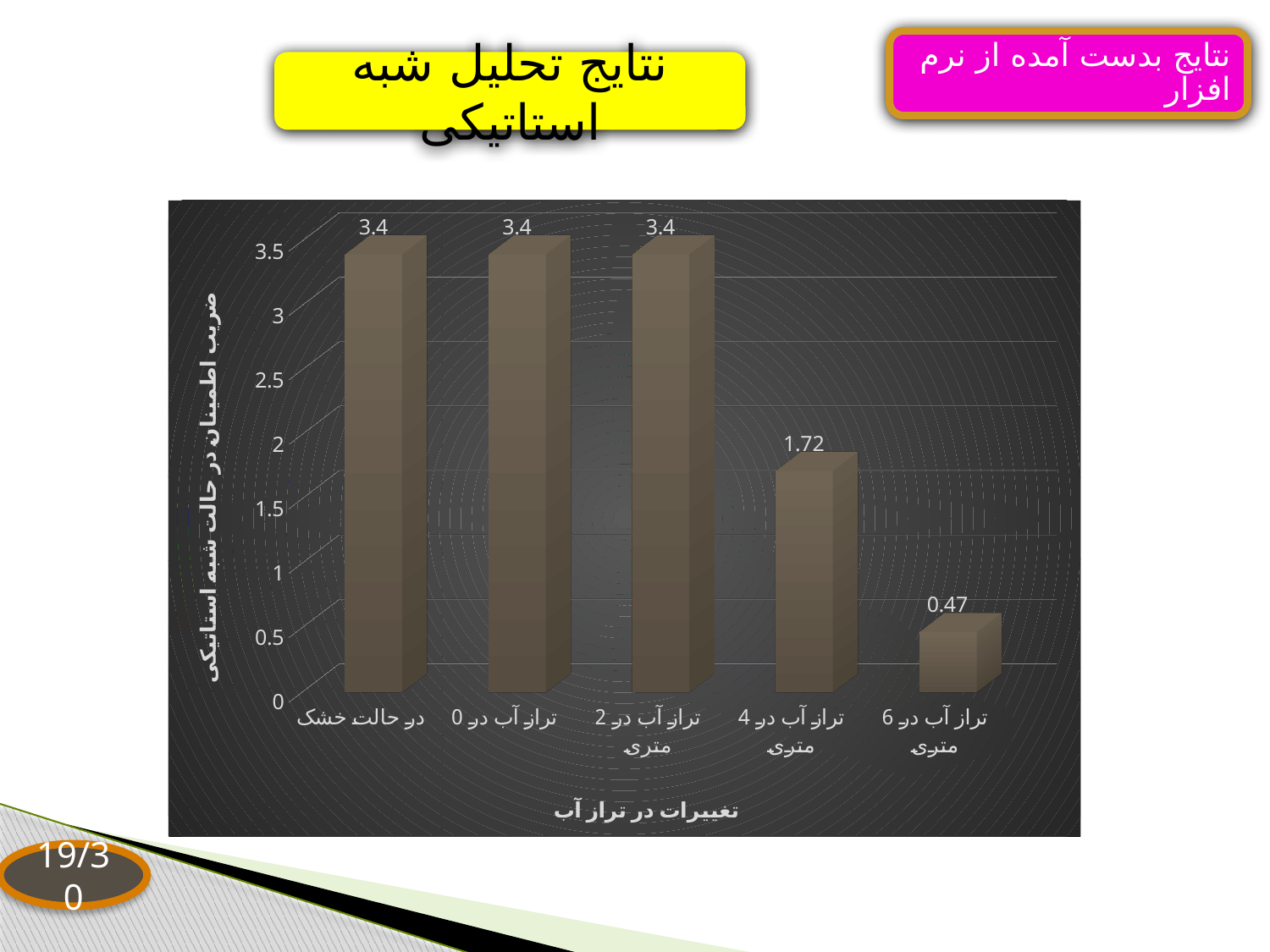
What is the value for the category "تراز آب در 4 متری" (water level at 4 m)? 1.72 What is the difference between the values for "تراز آب در 2 متری" and "تراز آب در 4 متری"? 1.68 Which category has the lowest value? تراز آب در 6 متری Which is larger, the value for "تراز آب در 0" or the value for "تراز آب در 4 متری"? تراز آب در 0 What kind of chart is shown on the slide? bar chart Do the values rise or fall moving from left to right along the x axis? fall What is the difference between the values for "تراز آب در 4 متری" and "تراز آب در 6 متری"? 1.25 What is the value for the category "در حالت خشک" (dry state)? 3.4 What is the title of the x axis? تغییرات در تراز آب Is the value for "تراز آب در 6 متری" greater or less than 1? less What is the value for the category "تراز آب در 6 متری" (water level at 6 m)? 0.47 How many categories are shown on the x axis? 5